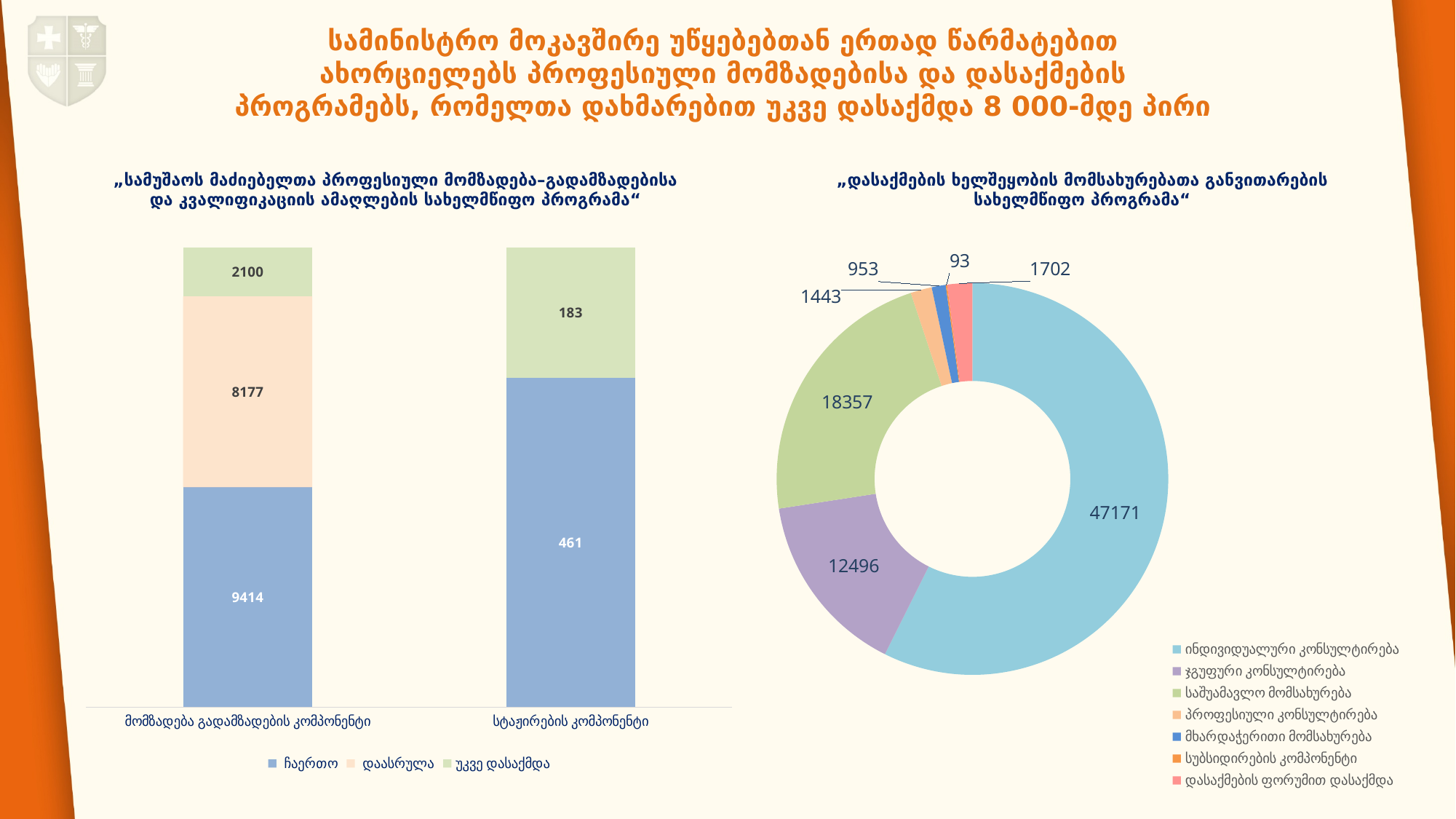
In the right doughnut chart, which category has the smallest value? სუბსიდირების კომპონენტი In the left bar chart, what is the value of ჩაერთო for მომზადება გადამზადების კომპონენტი? 9414 What type of chart is shown on the left side of the slide? stacked bar chart In the left bar chart, what is the value of უკვე დასაქმდა for სტაჟირების კომპონენტი? 183 In the right doughnut chart, which is larger: ჯგუფური კონსულტირება or საშუამავლო მომსახურება? საშუამავლო მომსახურება How many series does the legend of the left bar chart list? 3 In the left bar chart, what is the value of დაასრულა for მომზადება გადამზადების კომპონენტი? 8177 In the left bar chart, what is the total of the stacked bar for მომზადება გადამზადების კომპონენტი? 19691 What type of chart is shown on the right side of the slide? doughnut chart In the right doughnut chart, what is the value for ინდივიდუალური კონსულტირება? 47171 In the left bar chart, what is the difference between the ჩაერთო values of the two categories? 8953 How many categories does the legend of the right doughnut chart list? 7